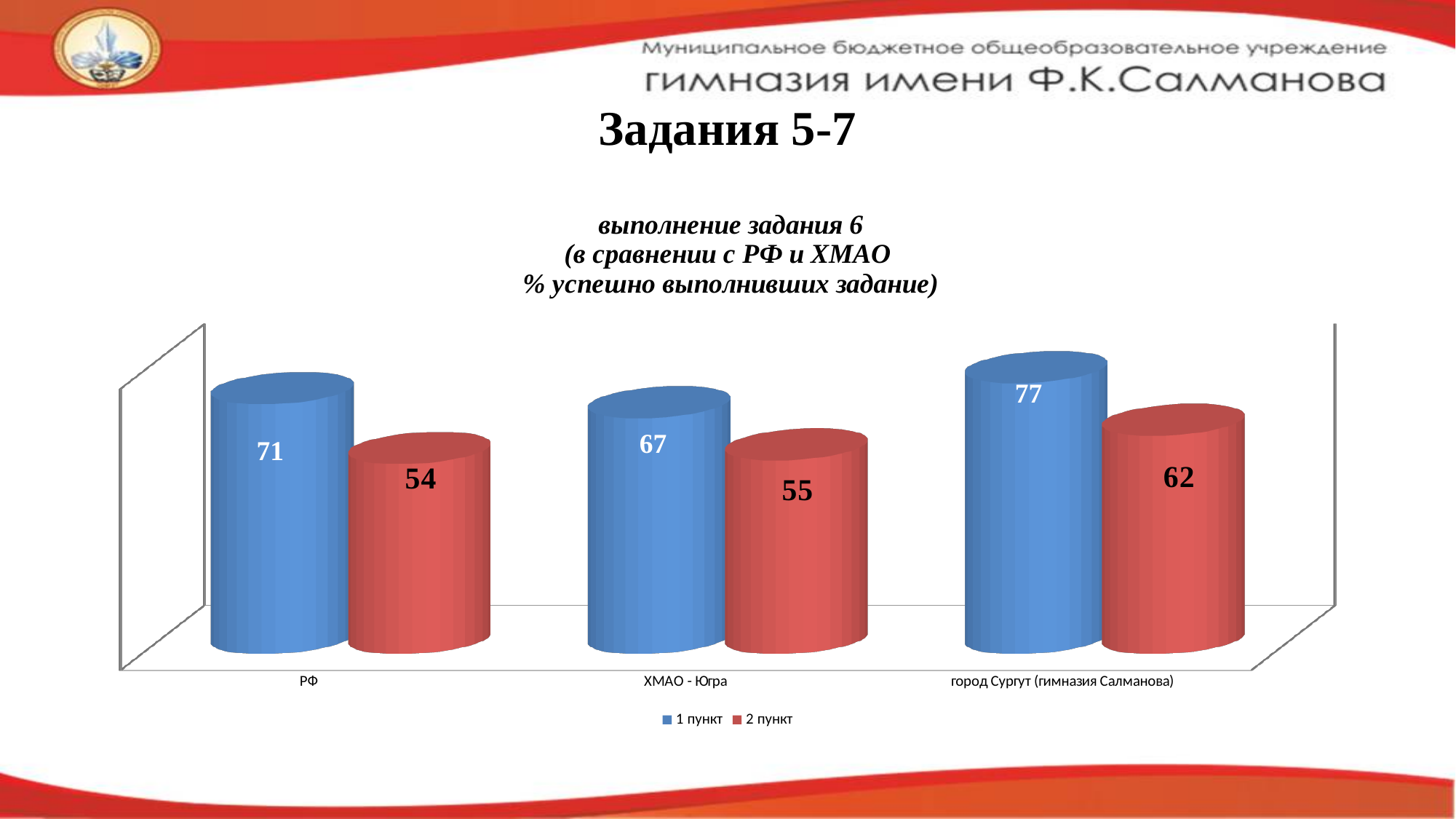
What is the value for "1 пункт" for РФ? 71 Which category has the lowest value for "2 пункт"? РФ Which colour represents the "2 пункт" series? red What is the value for "2 пункт" for РФ? 54 What is the difference between the "1 пункт" and "2 пункт" values for город Сургут (гимназия Салманова)? 15 Which category has the highest value for "1 пункт"? город Сургут (гимназия Салманова) How many categories are shown on the x axis? 3 What kind of chart is shown on the slide? bar chart What is the value for "2 пункт" for ХМАО - Югра? 55 How many series does the legend list? 2 What is the value for "1 пункт" for город Сургут (гимназия Салманова)? 77 Which is larger: the "1 пункт" value for РФ or the "1 пункт" value for ХМАО - Югра? РФ